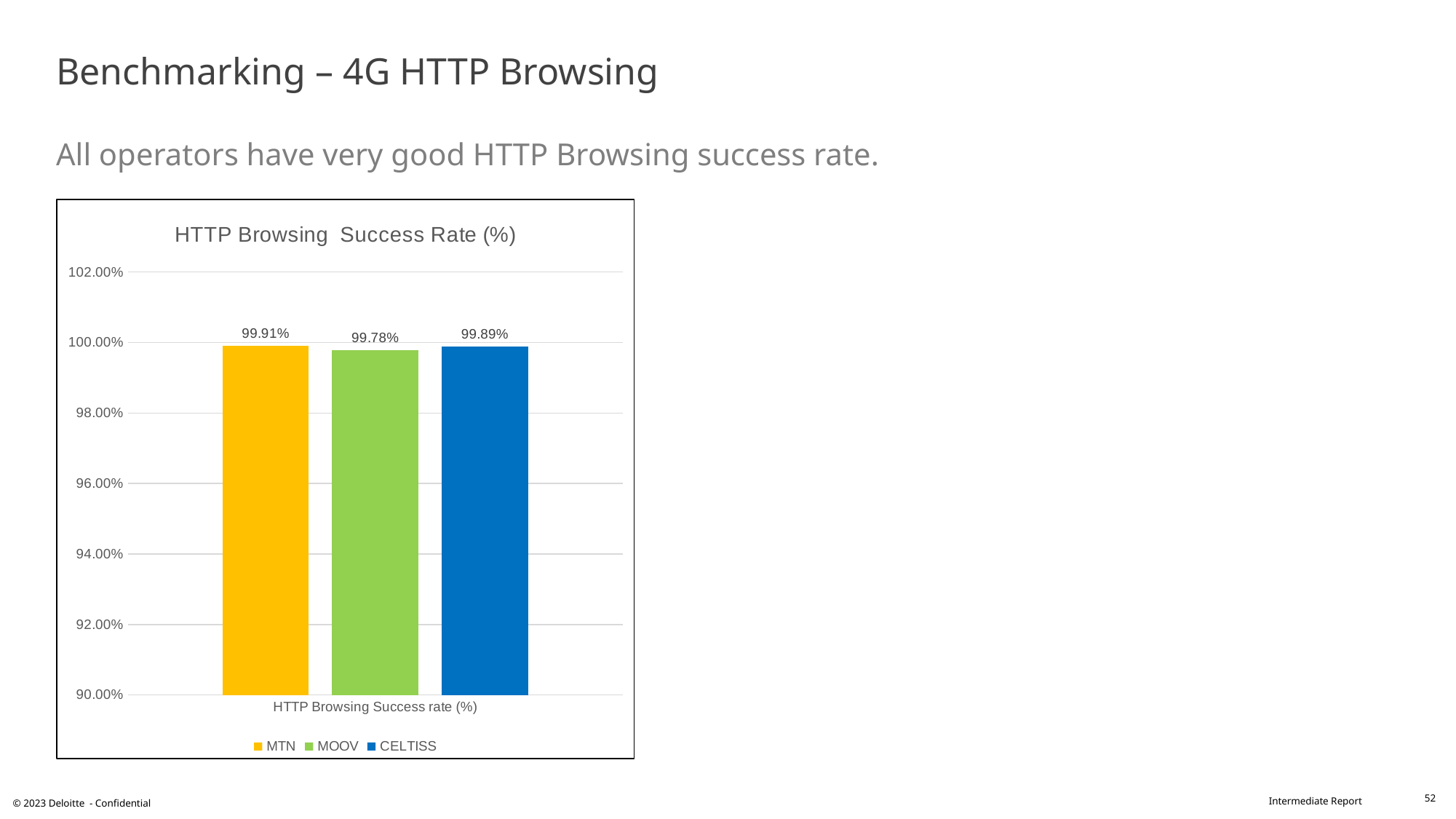
What is the difference between the HTTP Browsing success rates of MTN and MOOV? 0.13% Which operator has the lowest HTTP Browsing success rate? MOOV Which has a higher HTTP Browsing success rate, MTN or CELTISS? MTN What is the difference between the HTTP Browsing success rates of CELTISS and MOOV? 0.11% What is the HTTP Browsing success rate for CELTISS? 99.89% Is the value for MOOV greater or less than 98.00%? greater Which operator has the highest HTTP Browsing success rate? MTN What is the HTTP Browsing success rate for MOOV? 99.78% What is the title of the chart? HTTP Browsing Success Rate (%) What is the HTTP Browsing success rate for MTN? 99.91% How many series does the legend list? 3 What kind of chart is shown on the slide? Bar chart